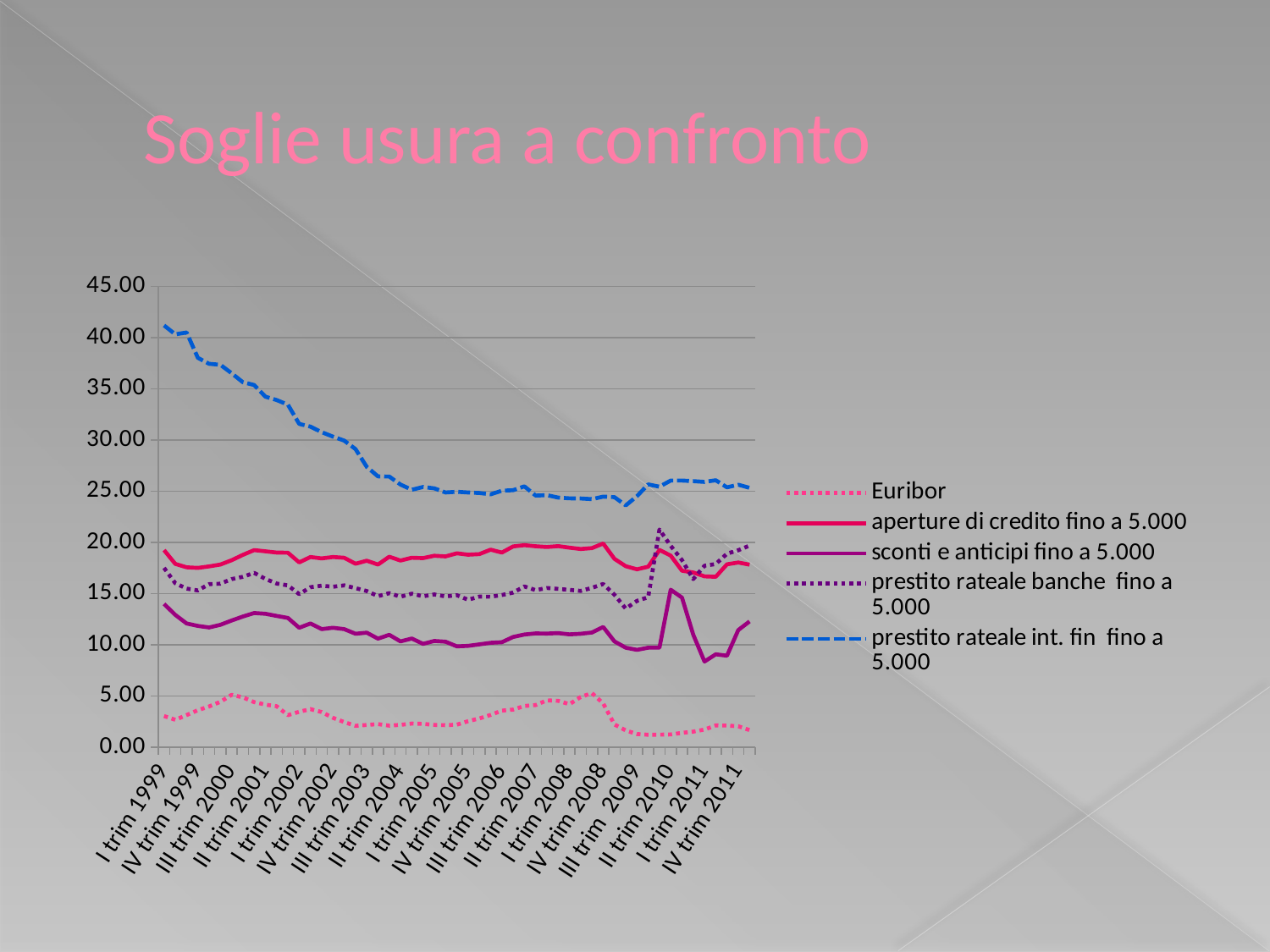
How many series does the legend list? 5 What kind of chart is shown on the slide? line chart Is the value for 'prestito rateale int. fin fino a 5.000' at IV trim 2011 greater or less than 30.00? less Which series is drawn as a blue dashed line? prestito rateale int. fin fino a 5.000 Which series has the lowest values across the whole period? Euribor Is the value for 'prestito rateale int. fin fino a 5.000' at I trim 1999 greater or less than 40.00? greater What is the title of the chart? Soglie usura a confronto Which series has the highest values across the whole period? prestito rateale int. fin fino a 5.000 At I trim 1999, which is larger: 'aperture di credito fino a 5.000' or 'sconti e anticipi fino a 5.000'? aperture di credito fino a 5.000 Is the value for 'aperture di credito fino a 5.000' at I trim 1999 greater or less than 20.00? less Does the value of 'prestito rateale int. fin fino a 5.000' rise or fall from I trim 1999 to IV trim 2011? fall